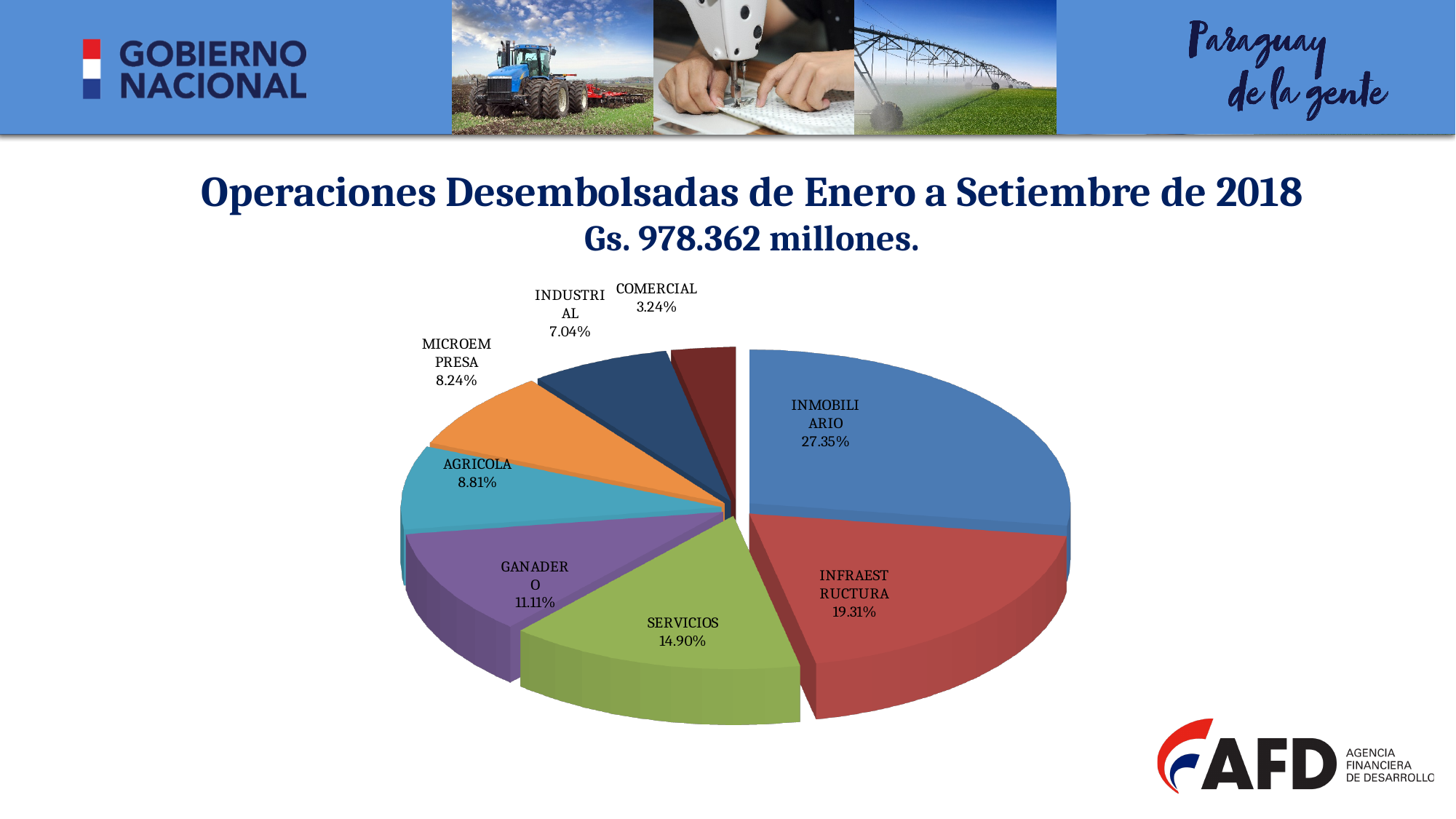
Which category has the smallest slice of the pie? COMERCIAL What is the difference in percentage points between MICROEMPRESA and INDUSTRIAL? 1.20 What is the value shown for INFRAESTRUCTURA? 19.31% What share of the pie does INMOBILIARIO represent? 27.35% What is the value shown for SERVICIOS? 14.90% How many categories are shown in the pie chart? 8 Which category has the largest slice of the pie? INMOBILIARIO What total amount in millions of Gs. is stated in the chart title? Gs. 978.362 millones. What is the value shown for COMERCIAL? 3.24% Which is larger, the share for GANADERO or the share for AGRICOLA? GANADERO What is the difference in percentage points between INMOBILIARIO and INFRAESTRUCTURA? 8.04 What kind of chart is shown on the slide? Pie chart